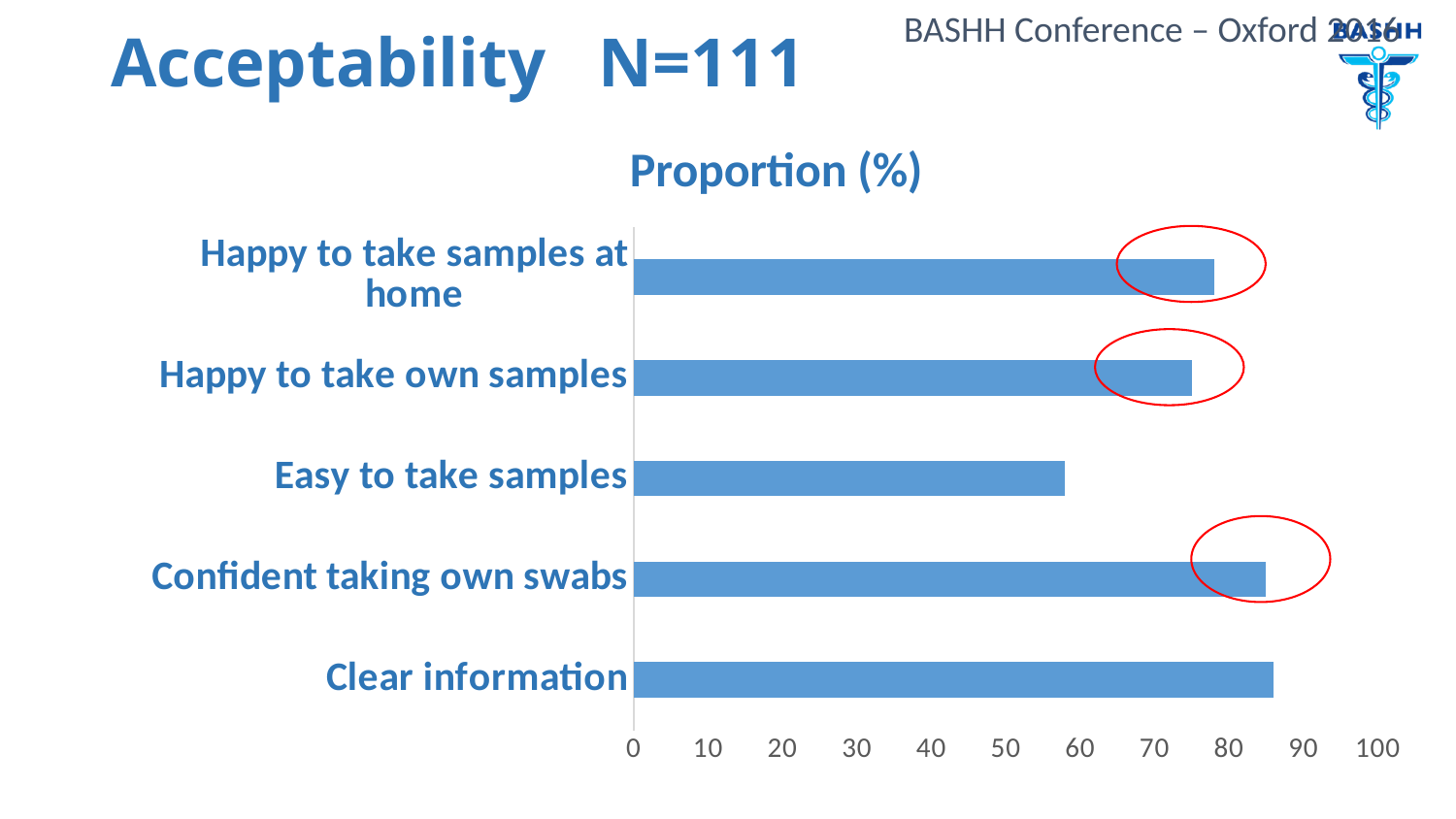
Which is larger, the value for Confident taking own swabs or the value for Easy to take samples? Confident taking own swabs Is the value for Confident taking own swabs greater or less than 80? greater Is the value for Happy to take samples at home greater or less than 70? greater Which category has the lowest value in the chart? Easy to take samples Is the value for Happy to take own samples greater or less than 80? less What is the highest value shown on the chart's horizontal axis? 100 What kind of chart is shown on the slide? bar chart What is the title of the chart? Proportion (%) Which is larger, the value for Happy to take own samples or the value for Easy to take samples? Happy to take own samples How many categories are plotted in the chart? 5